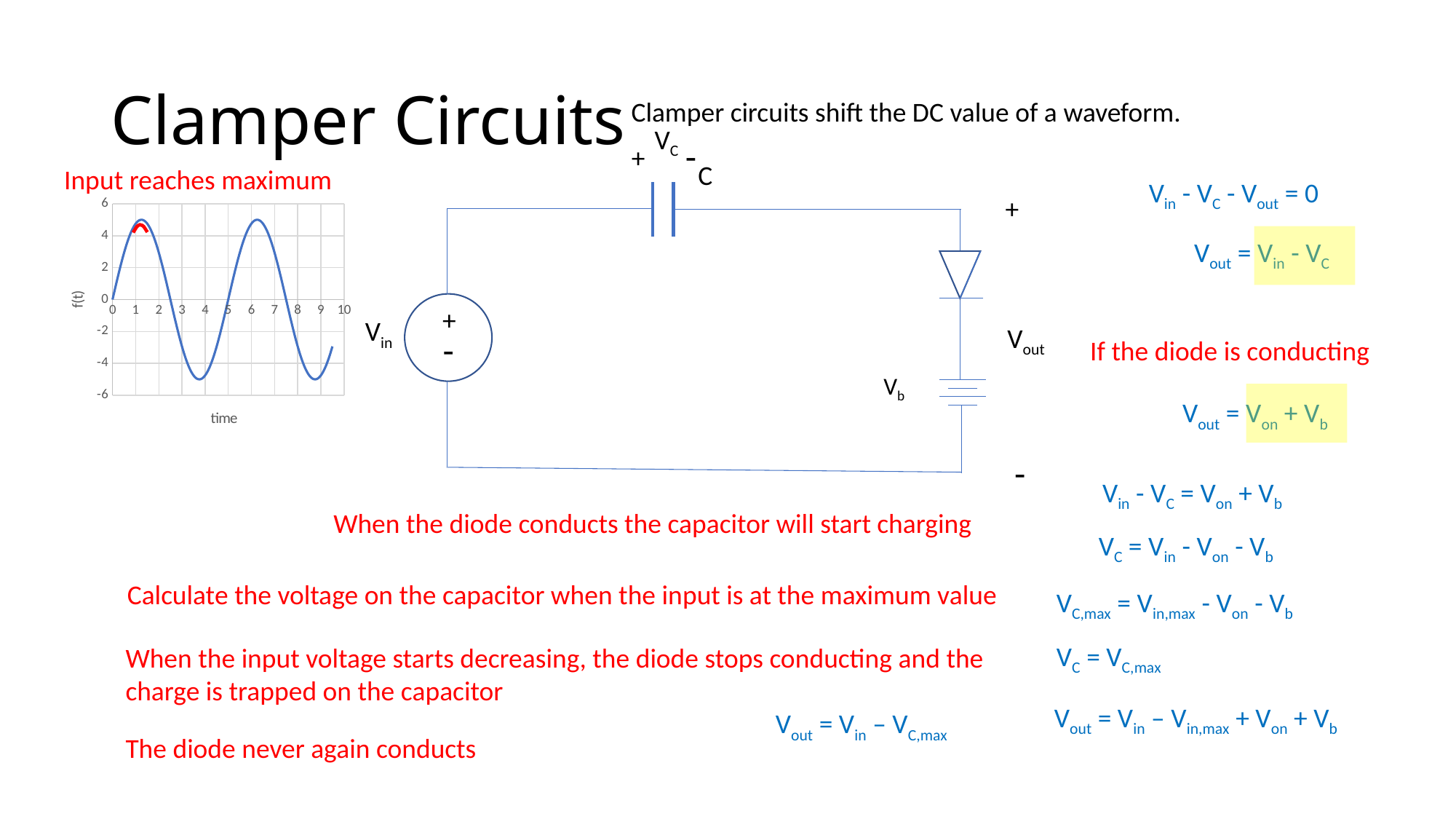
What is the value of f(t) at time 0 on the chart? 0 Does f(t) rise or fall between time 2 and time 3 on the chart? fall Is the value of f(t) at time 1 greater or less than 4? greater Does f(t) rise or fall between time 0 and time 1 on the chart? rise What is the label on the vertical axis of the chart? f(t) What kind of chart is shown on the left of the slide? line chart What is the label on the horizontal axis of the chart? time Is the value of f(t) at time 6 greater or less than 4? greater What is the highest tick value shown on the vertical axis of the chart? 6 What is the largest tick value shown on the horizontal axis of the chart? 10 Is the value of f(t) at time 4 greater or less than -4? less What is the lowest tick value shown on the vertical axis of the chart? -6